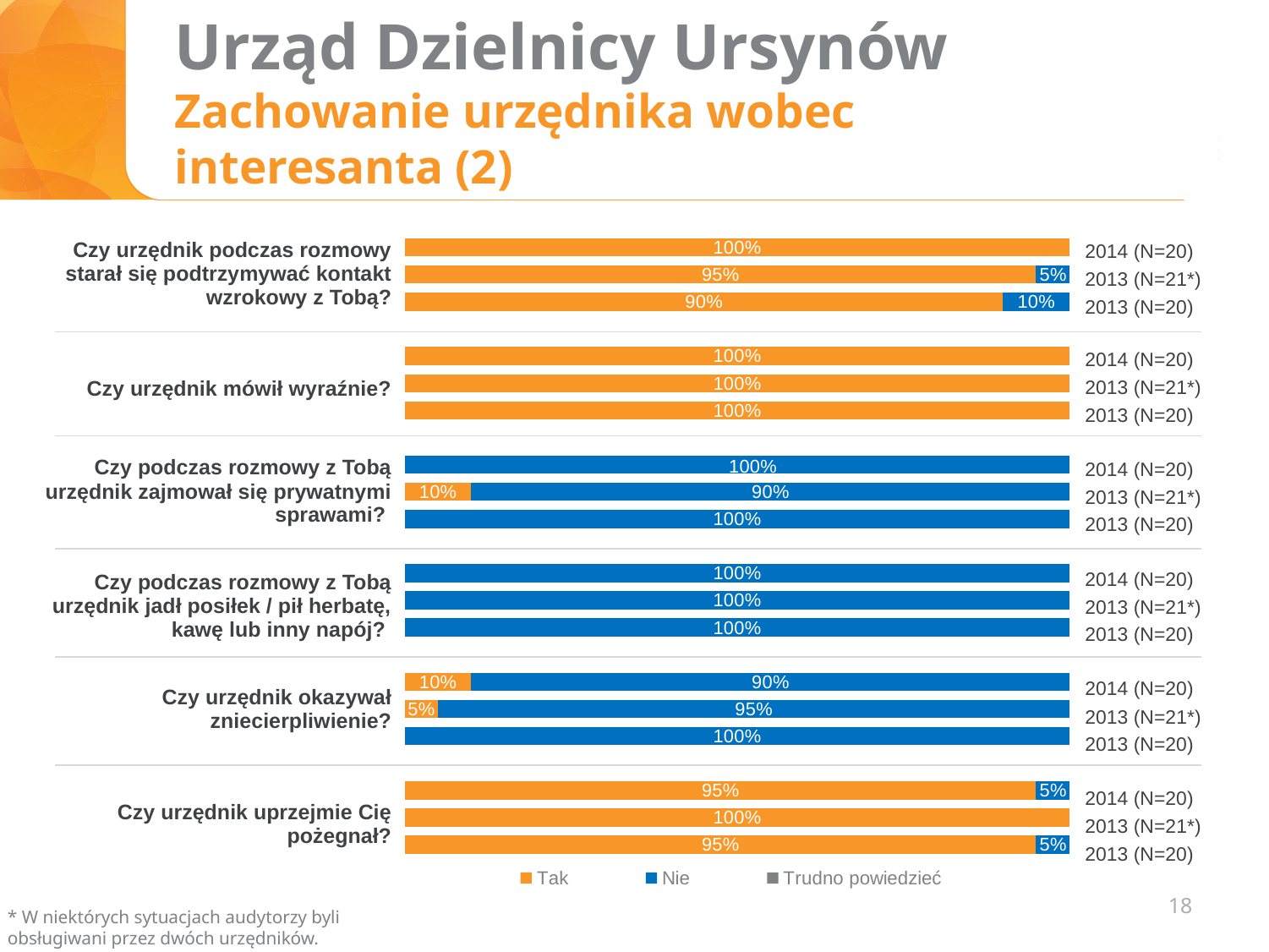
What is the difference between the 'Tak' values for 'Czy urzędnik podczas rozmowy starał się podtrzymywać kontakt wzrokowy z Tobą?' in 2014 (N=20) and 2013 (N=20)? 10% What are the legend entries of the chart? Tak, Nie, Trudno powiedzieć Which is larger for 'Czy urzędnik okazywał zniecierpliwienie?': the 'Tak' value in 2014 (N=20) or in 2013 (N=21*)? 2014 (N=20) How many survey questions (categories) are shown on the chart? 6 What is the 'Tak' value for 'Czy podczas rozmowy z Tobą urzędnik zajmował się prywatnymi sprawami?' in 2013 (N=21*)? 10% What is the 'Tak' value for 'Czy urzędnik uprzejmie Cię pożegnał?' in 2013 (N=21*)? 100% What is the 'Tak' value for 'Czy urzędnik podczas rozmowy starał się podtrzymywać kontakt wzrokowy z Tobą?' in 2014 (N=20)? 100% What is the total of the stacked bar for 'Czy urzędnik uprzejmie Cię pożegnał?' in 2014 (N=20)? 100% How many series does the legend list? 3 What is the 'Nie' value for 'Czy urzędnik okazywał zniecierpliwienie?' in 2014 (N=20)? 90% What kind of chart is shown on the slide? stacked bar chart What is the 'Nie' value for 'Czy urzędnik podczas rozmowy starał się podtrzymywać kontakt wzrokowy z Tobą?' in 2013 (N=20)? 10%